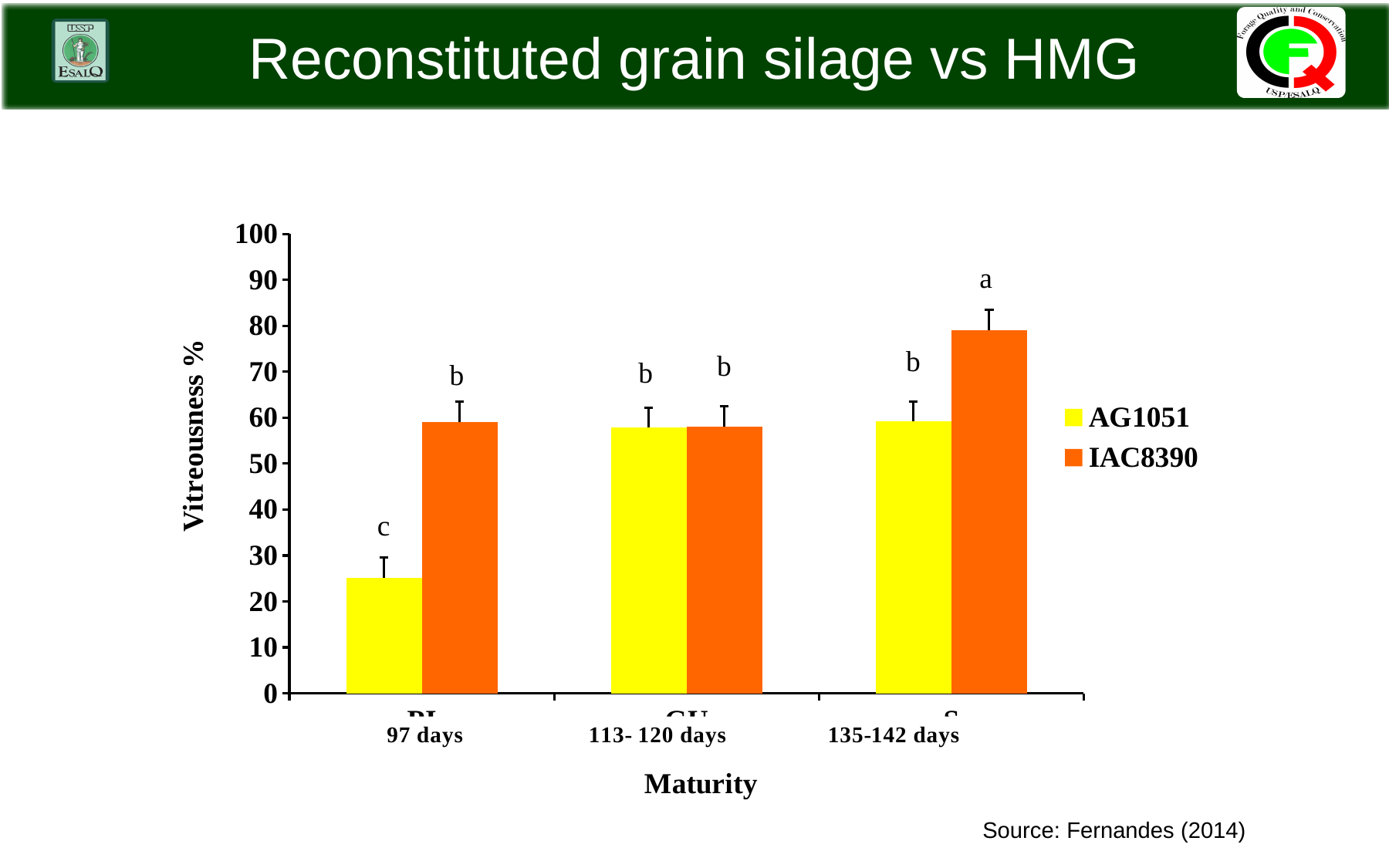
At 97 days, which series has the larger value, AG1051 or IAC8390? IAC8390 Which series is shown in yellow? AG1051 Which bar has the lowest vitreousness value in the chart? AG1051 at 97 days Is the value for AG1051 at 97 days greater or less than 30? less Which bar has the highest vitreousness value in the chart? IAC8390 at 135-142 days At 135-142 days, which series has the larger value, AG1051 or IAC8390? IAC8390 Is the value for IAC8390 at 135-142 days greater or less than 70? greater How many maturity categories are shown on the x axis? 3 What kind of chart is shown on the slide? bar chart What is the label of the y axis? Vitreousness % Is the value for IAC8390 at 97 days greater or less than 50? greater How many series does the legend list? 2